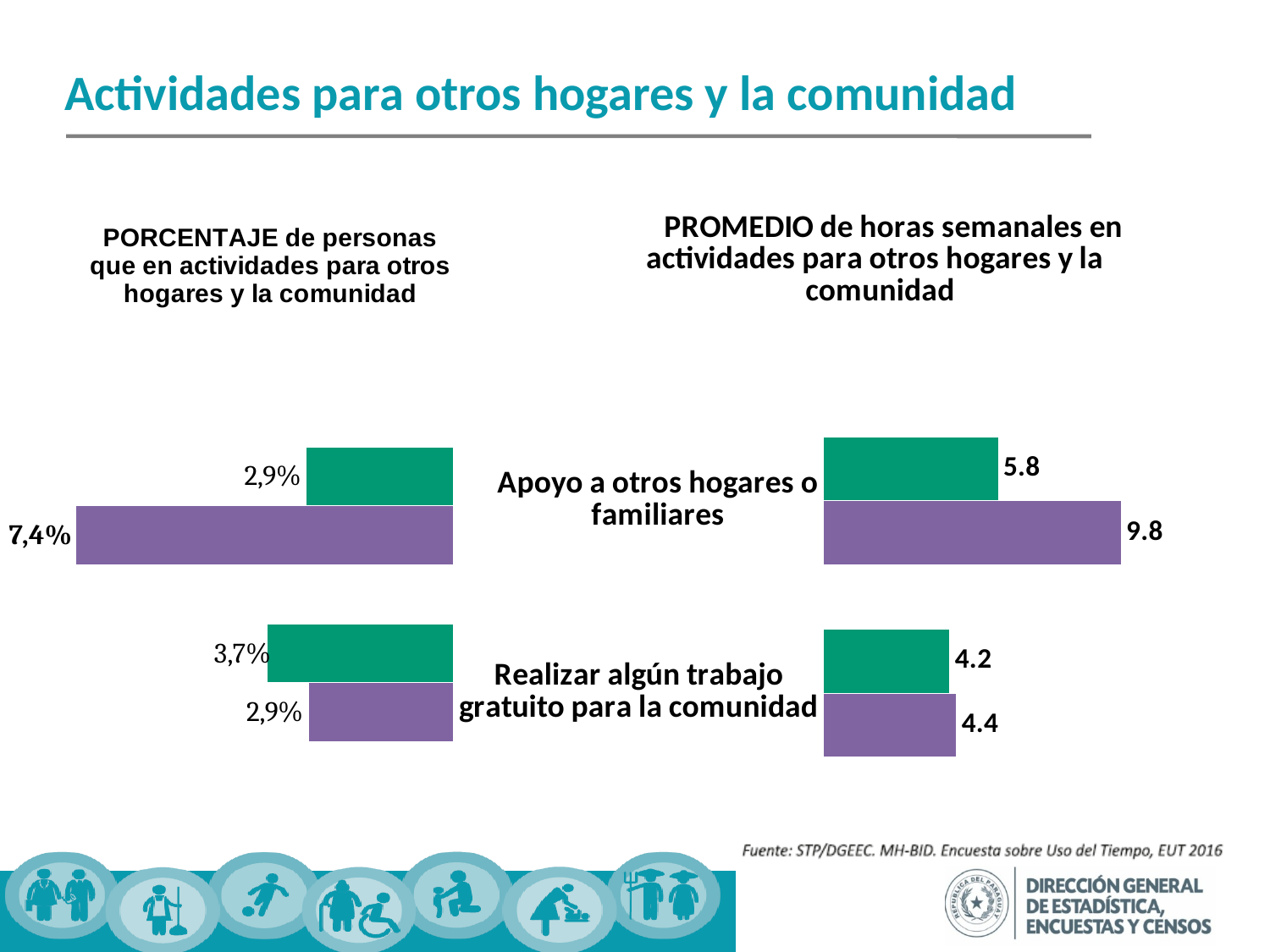
In the PORCENTAJE chart on the left, what is the value of the green bar for "Realizar algún trabajo gratuito para la comunidad"? 3,7% What kind of chart is the PORCENTAJE chart on the left? Bar chart In the PORCENTAJE chart on the left, what is the value of the purple bar for "Apoyo a otros hogares o familiares"? 7,4% How many categories are shown in the PROMEDIO de horas semanales chart on the right? 2 In the PROMEDIO de horas semanales chart on the right, what is the value of the purple bar for "Apoyo a otros hogares o familiares"? 9.8 In the PROMEDIO de horas semanales chart on the right, what is the difference between the purple and green bars for "Apoyo a otros hogares o familiares"? 4.0 In the PORCENTAJE chart on the left, which bar has the highest value? The purple bar for Apoyo a otros hogares o familiares (7,4%) In the PROMEDIO de horas semanales chart on the right, what is the value of the green bar for "Realizar algún trabajo gratuito para la comunidad"? 4.2 In the PORCENTAJE chart on the left, what is the difference between the purple and green bars for "Apoyo a otros hogares o familiares"? 4,5% What is the title of the chart on the right? PROMEDIO de horas semanales en actividades para otros hogares y la comunidad In the PORCENTAJE chart on the left, for "Realizar algún trabajo gratuito para la comunidad", which bar is larger, the green or the purple? green In the PROMEDIO de horas semanales chart on the right, which category has the highest value? Apoyo a otros hogares o familiares